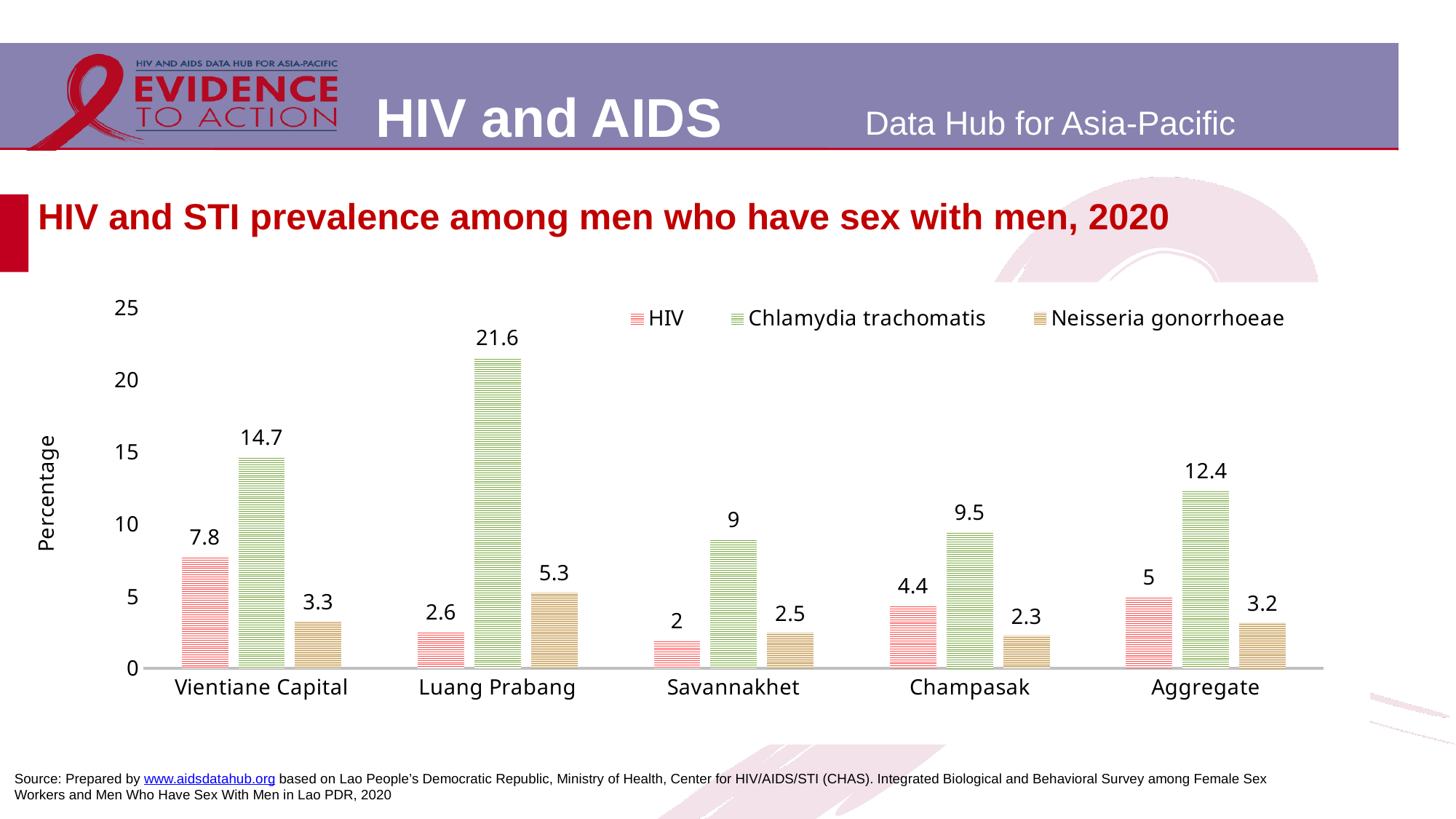
Which province has the highest Chlamydia trachomatis prevalence? Luang Prabang What is the Chlamydia trachomatis prevalence for Luang Prabang? 21.6 What kind of chart is shown on the slide? Bar chart Which category has the lowest HIV prevalence? Savannakhet Is the Chlamydia trachomatis value for Aggregate greater or less than 10? greater How many series does the legend list? 3 How many categories are shown on the x axis? 5 What is the Neisseria gonorrhoeae prevalence for Aggregate? 3.2 What is the label of the y axis? Percentage What is the HIV prevalence for Vientiane Capital? 7.8 What is the difference between the Chlamydia trachomatis and HIV prevalence in Vientiane Capital? 6.9 Which is larger, the HIV prevalence in Champasak or in Luang Prabang? Champasak